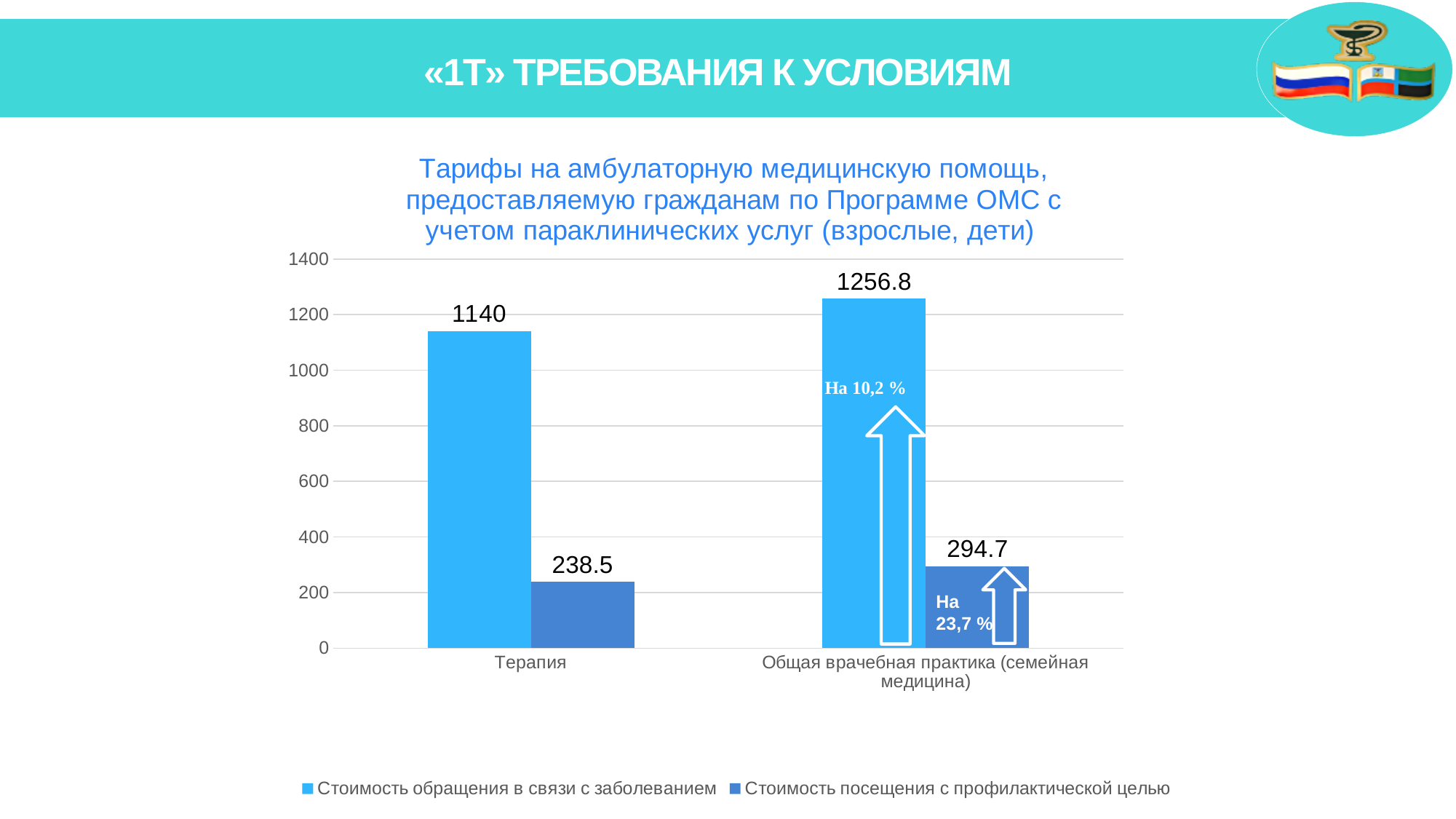
What kind of chart is shown on the slide? Bar chart Which category has the lowest value for "Стоимость посещения с профилактической целью"? Терапия How many categories are shown on the x axis? 2 What is the value of "Стоимость посещения с профилактической целью" for Общая врачебная практика (семейная медицина)? 294.7 How many series does the legend list? 2 What is the difference between the "Стоимость обращения в связи с заболеванием" values for Общая врачебная практика (семейная медицина) and Терапия? 116.8 Which category has the highest value for "Стоимость обращения в связи с заболеванием"? Общая врачебная практика (семейная медицина) What is the value of "Стоимость посещения с профилактической целью" for Терапия? 238.5 Which is larger: "Стоимость обращения в связи с заболеванием" for Терапия or for Общая врачебная практика (семейная медицина)? Общая врачебная практика (семейная медицина) What is the value of "Стоимость обращения в связи с заболеванием" for Терапия? 1140 What is the difference between the "Стоимость посещения с профилактической целью" values for Общая врачебная практика (семейная медицина) and Терапия? 56.2 What is the value of "Стоимость обращения в связи с заболеванием" for Общая врачебная практика (семейная медицина)? 1256.8